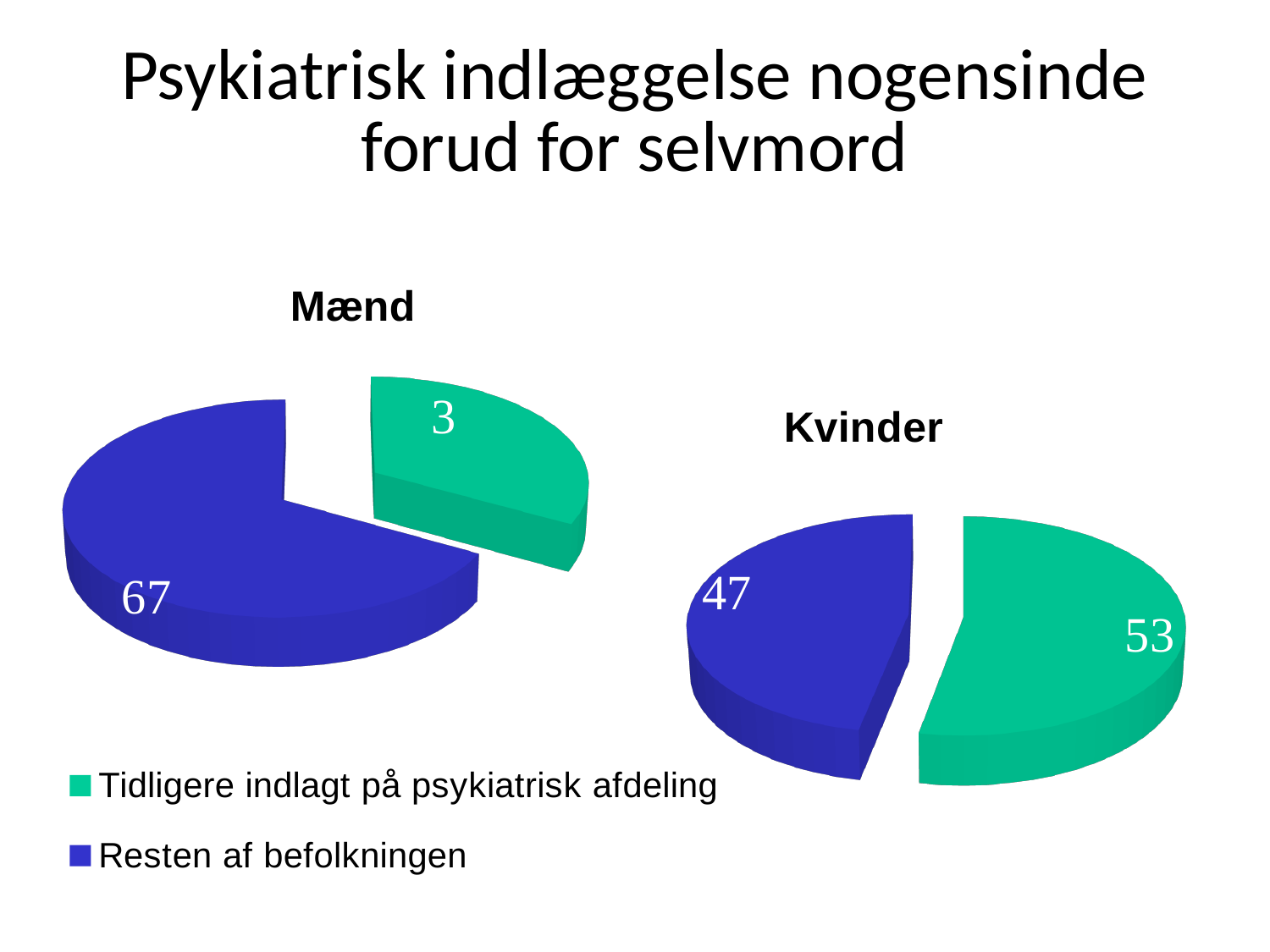
In the "Kvinder" chart, what is the total of the two slice values? 100 What colour represents "Resten af befolkningen" in the charts? blue In the "Kvinder" chart, what is the value for "Tidligere indlagt på psykiatrisk afdeling"? 53 What kind of chart is the "Mænd" chart? pie chart How many slices does the "Kvinder" chart have? 2 In the "Mænd" chart, which slice is the smallest? Tidligere indlagt på psykiatrisk afdeling In the "Kvinder" chart, which slice is larger: "Tidligere indlagt på psykiatrisk afdeling" or "Resten af befolkningen"? Tidligere indlagt på psykiatrisk afdeling In the "Kvinder" chart, what is the value for "Resten af befolkningen"? 47 In the "Mænd" chart, what is the value for "Resten af befolkningen"? 67 In the "Mænd" chart, which slice is the largest? Resten af befolkningen In the "Kvinder" chart, what is the difference between the values for "Tidligere indlagt på psykiatrisk afdeling" and "Resten af befolkningen"? 6 How many entries does the legend list? 2